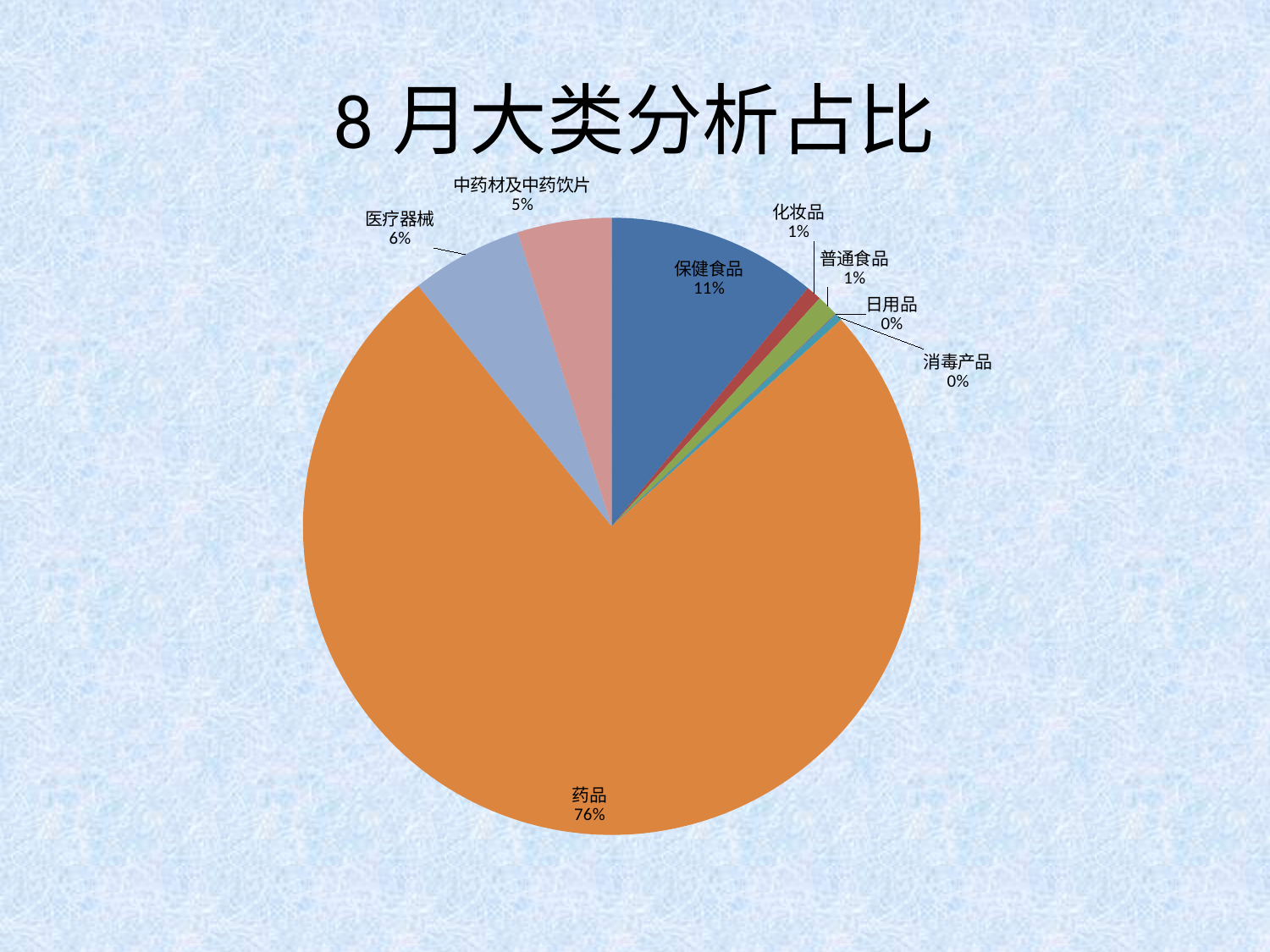
What is the title of the chart? 8 月大类分析占比 Which category has the largest share of the pie? 药品 What is the value shown for 中药材及中药饮片? 5% What is the difference in percentage points between 药品 and 保健食品? 65% What is the value shown for 医疗器械? 6% What share of the pie does 药品 take? 76% How many categories are shown in the pie chart? 8 Which is larger, the share for 医疗器械 or the share for 中药材及中药饮片? 医疗器械 What type of chart is shown on the slide? pie chart What is the value shown for 保健食品? 11% What is the value shown for 化妆品? 1% What is the value shown for 消毒产品? 0%